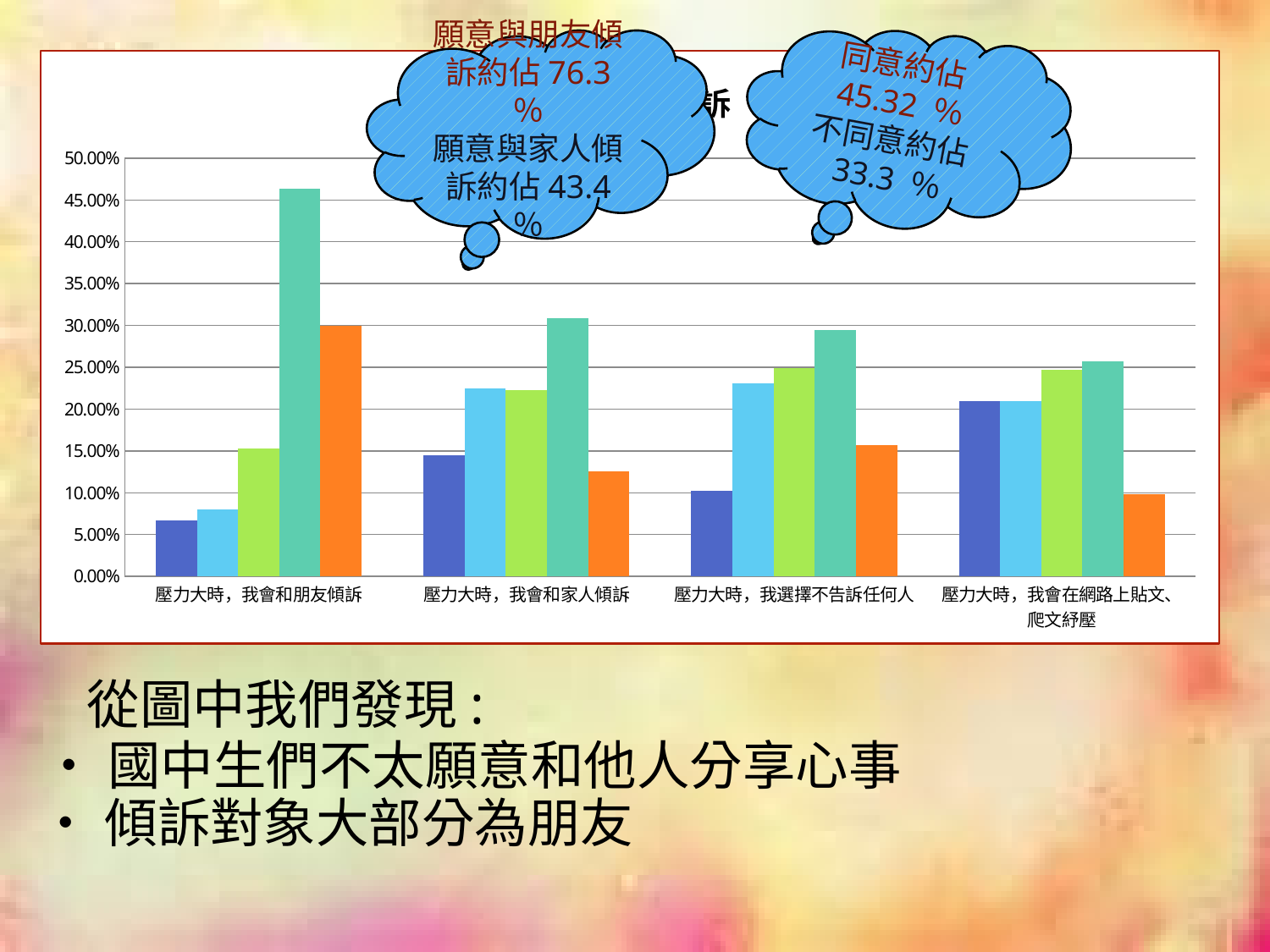
Is the value of the teal bar for 壓力大時，我會和朋友傾訴 greater or less than 40.00%? greater Which is larger: the teal bar for 壓力大時，我會和朋友傾訴 or the teal bar for 壓力大時，我會和家人傾訴? 壓力大時，我會和朋友傾訴 According to the left cloud callout on the slide, what share of students are willing to confide in friends (願意與朋友傾訴)? 76.3% Which is larger: the orange bar for 壓力大時，我會和朋友傾訴 or the orange bar for 壓力大時，我會在網路上貼文、爬文紓壓? 壓力大時，我會和朋友傾訴 Is the value of the orange bar for 壓力大時，我會和家人傾訴 greater or less than 15.00%? less How many categories are shown on the x axis of the chart? 4 Which category contains the tallest bar in the chart? 壓力大時，我會和朋友傾訴 What kind of chart is shown on the slide? bar chart Which category contains the shortest bar in the chart? 壓力大時，我會和朋友傾訴 How many bars are plotted for each category in the chart? 5 Is the value of the teal bar for 壓力大時，我會和家人傾訴 greater or less than 30.00%? greater